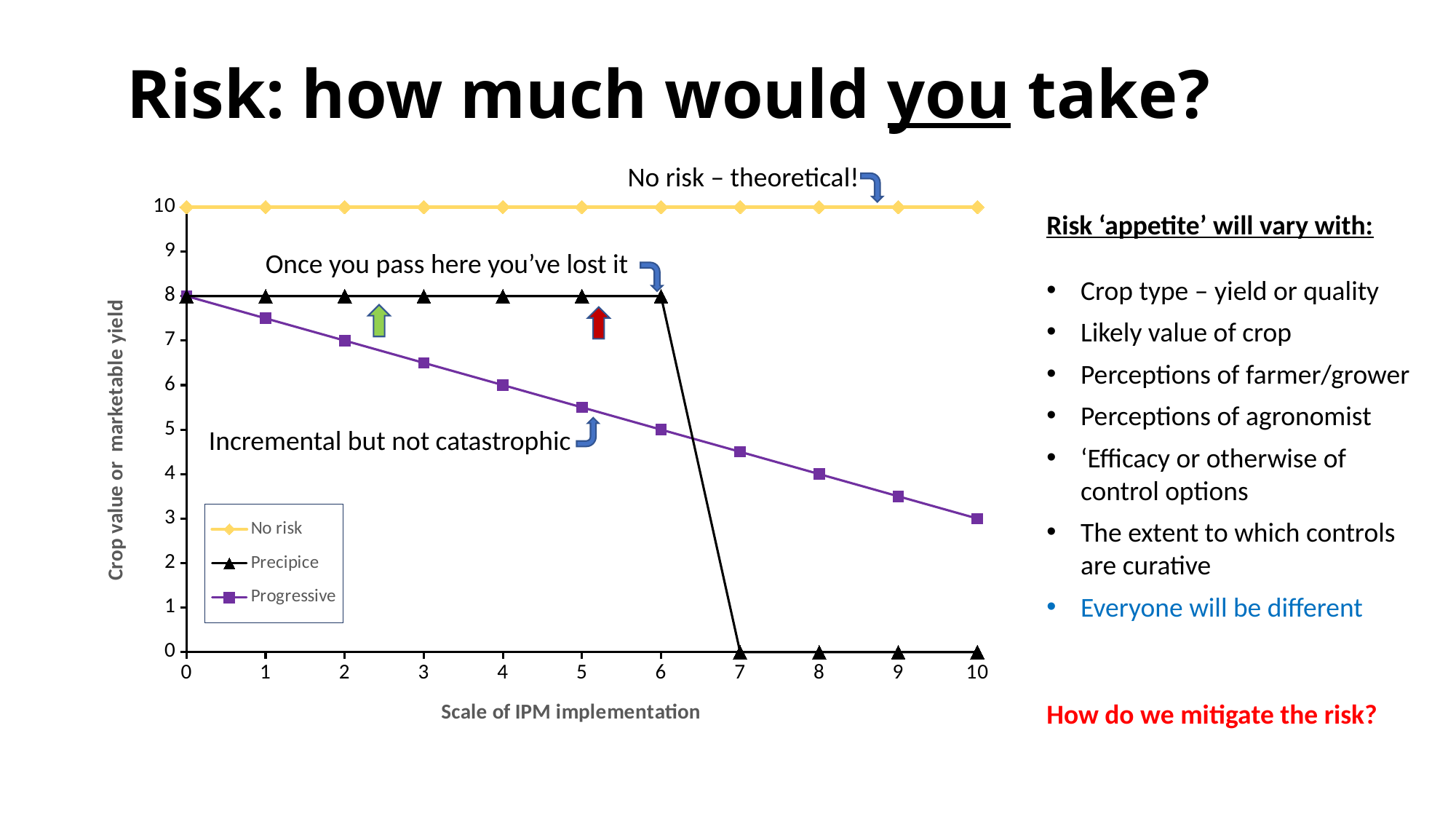
Does the Progressive series rise or fall as the scale of IPM implementation increases? Fall How many series does the chart legend list? 3 What is the value of the Progressive series at a scale of IPM implementation of 6? 5 What is the value of the Precipice series at a scale of IPM implementation of 3? 8 At a scale of IPM implementation of 4, which series has the larger value, Precipice or Progressive? Precipice Which series has the lowest value at a scale of IPM implementation of 7? Precipice Is the value of the Progressive series at a scale of IPM implementation of 1 greater or less than 7? greater What kind of chart is shown on the slide? Line chart What is the value of the No risk series at a scale of IPM implementation of 5? 10 What is the value of the Progressive series at a scale of IPM implementation of 10? 3 What is the value of the Precipice series at a scale of IPM implementation of 8? 0 Which series has the highest value at a scale of IPM implementation of 9? No risk